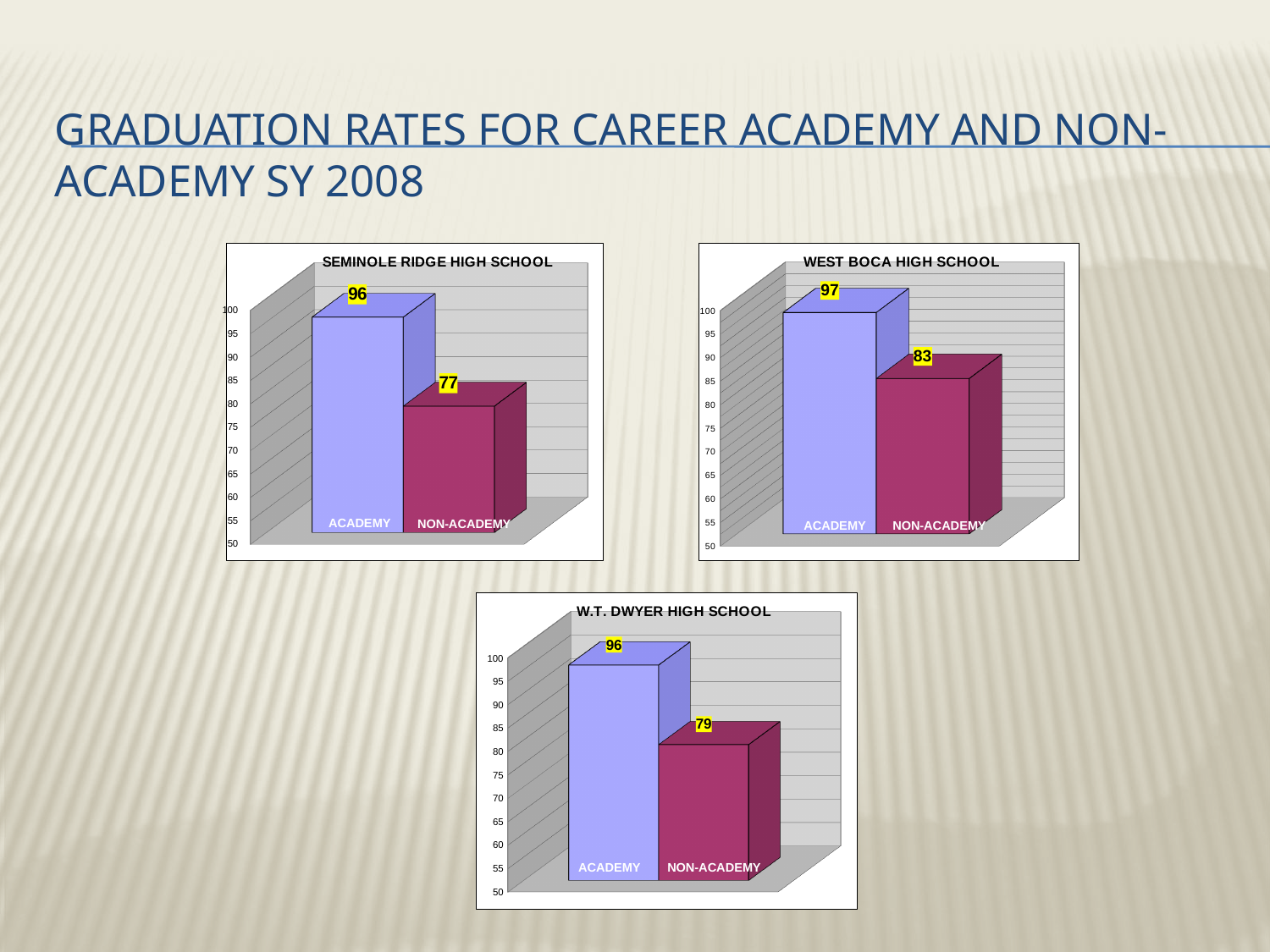
In the West Boca High School chart, what is the value for Academy? 97 In the Seminole Ridge High School chart, what is the graduation rate for Academy? 96 In the Seminole Ridge High School chart, which category has the higher value? Academy What kind of chart is the Seminole Ridge High School chart? Bar chart In the West Boca High School chart, what is the difference between the Academy and Non-Academy values? 14 In the W.T. Dwyer High School chart, what is the difference between the Academy and Non-Academy values? 17 In the W.T. Dwyer High School chart, what is the value for Non-Academy? 79 In the Seminole Ridge High School chart, what is the graduation rate for Non-Academy? 77 In the W.T. Dwyer High School chart, is the value for Academy greater or less than 90? greater In the West Boca High School chart, what is the value for Non-Academy? 83 In the West Boca High School chart, which category has the lowest value? Non-Academy How many categories are shown in the West Boca High School chart? 2